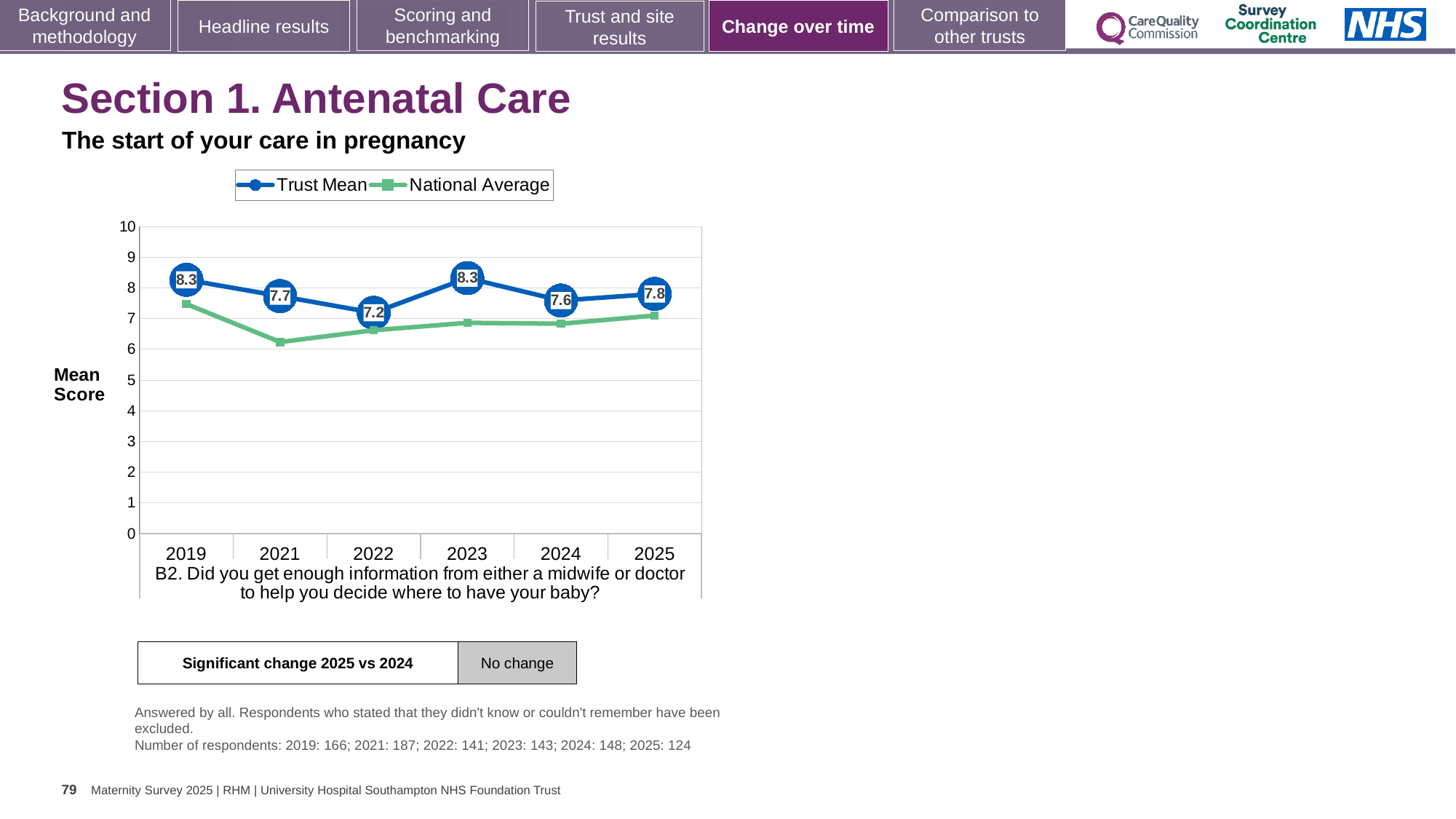
Does the Trust Mean rise or fall from 2019 to 2022? Fall What is the Trust Mean value for 2019? 8.3 What is the Trust Mean value for 2022? 7.2 Is the National Average value for 2019 greater or less than 7? greater In which year is the Trust Mean lowest? 2022 Is the National Average value for 2021 greater or less than 7? less How many series does the legend list? 2 What is the difference between the Trust Mean in 2023 and in 2024? 0.7 What is the Trust Mean value for 2025? 7.8 How many years are plotted on the x axis? 6 What kind of chart is shown? Line chart Which year has the higher Trust Mean, 2021 or 2022? 2021